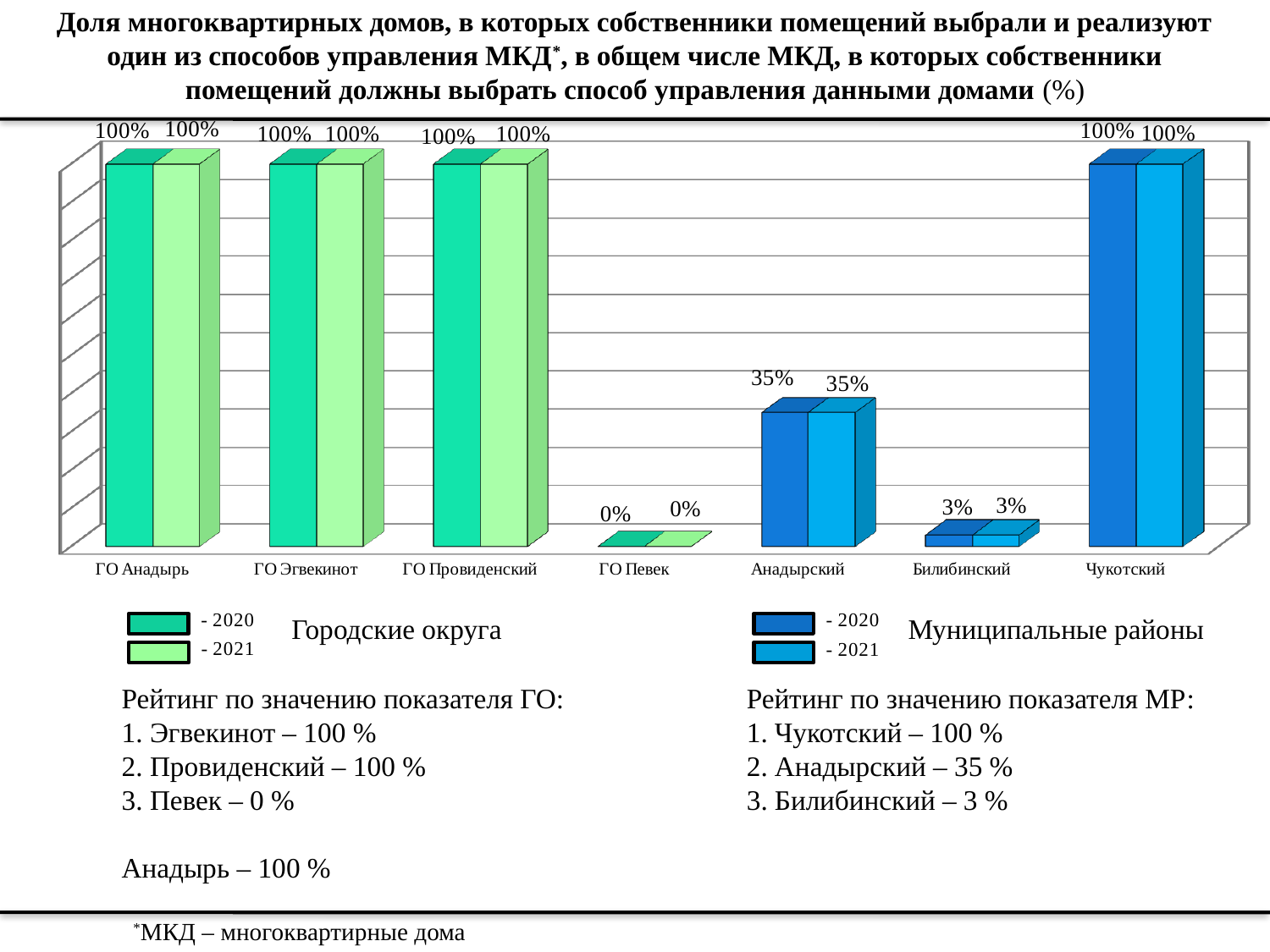
What is the difference between the 2021 values for Анадырский and Билибинский? 32% What is the 2021 value for ГО Певек? 0% How many categories are shown along the x axis of the chart? 7 What kind of chart is shown on the slide? bar chart What is the difference between the 2020 value for ГО Анадырь and the 2020 value for Анадырский? 65% What is the 2020 value for Чукотский? 100% Which two years do the legend entries represent? 2020 and 2021 What is the 2021 value for Анадырский? 35% Which is larger, the 2020 value for Анадырский or the 2020 value for Билибинский? Анадырский Which colour is used for the bars of the municipal districts (Муниципальные районы)? blue What is the 2020 value for Билибинский? 3% Which category has the lowest values in the chart? ГО Певек